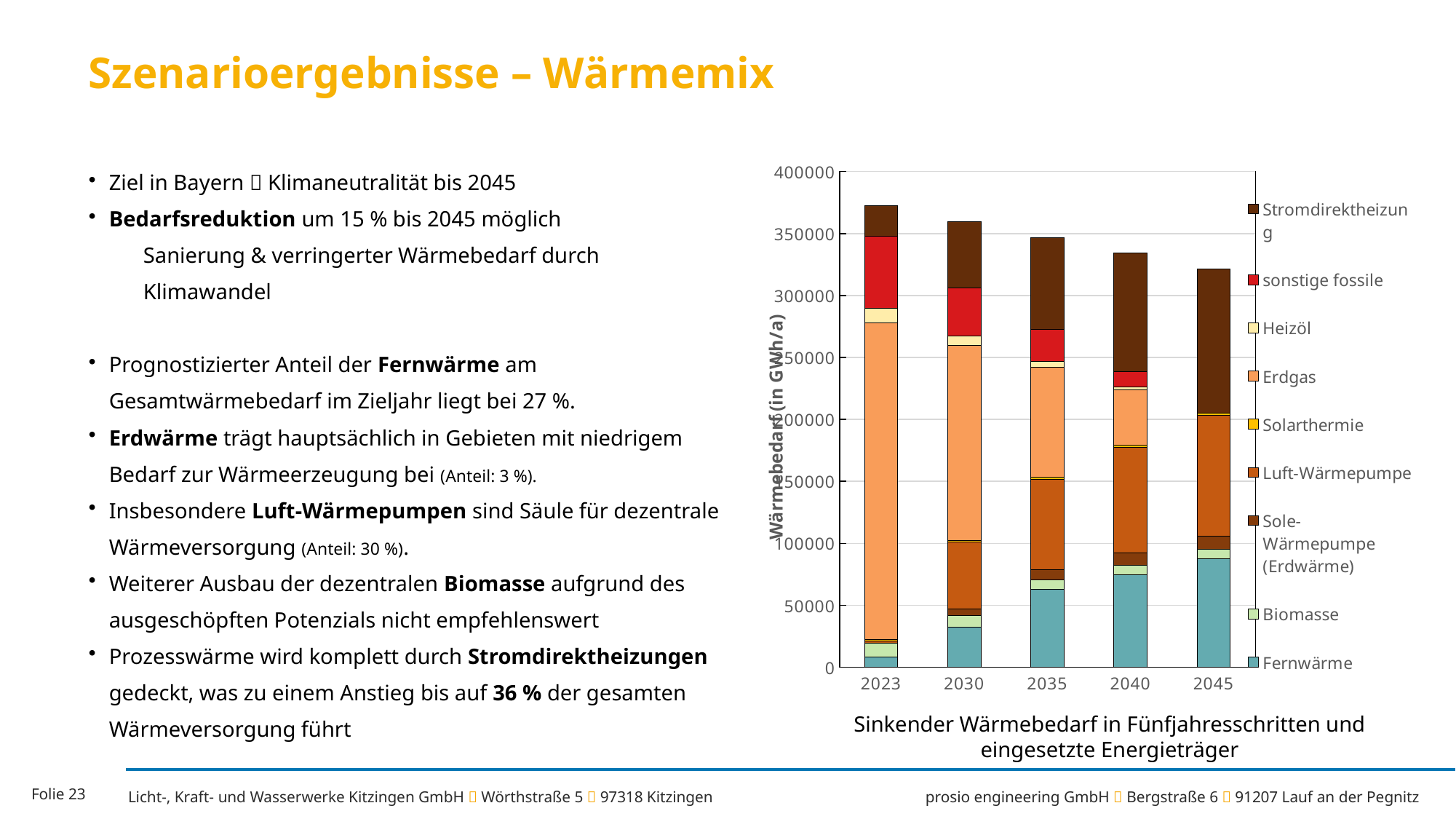
How many series does the chart legend list? 9 Which year has the tallest stacked bar (highest total Wärmebedarf)? 2023 Which year has the shortest stacked bar (lowest total Wärmebedarf)? 2045 Is the Fernwärme value for 2045 greater or less than 50000? greater Which year has the larger Fernwärme segment, 2023 or 2045? 2045 How many years are shown on the x axis of the chart? 5 Which year has the larger Erdgas segment, 2023 or 2045? 2023 What is the label of the y axis of the chart? Wärmebedarf (in GWh/a) What kind of chart is shown on the slide? Stacked bar chart Is the total stacked bar for 2023 greater or less than 350000? greater Is the total stacked bar for 2045 greater or less than 350000? less Does the total Wärmebedarf rise or fall from 2023 to 2045? Fall